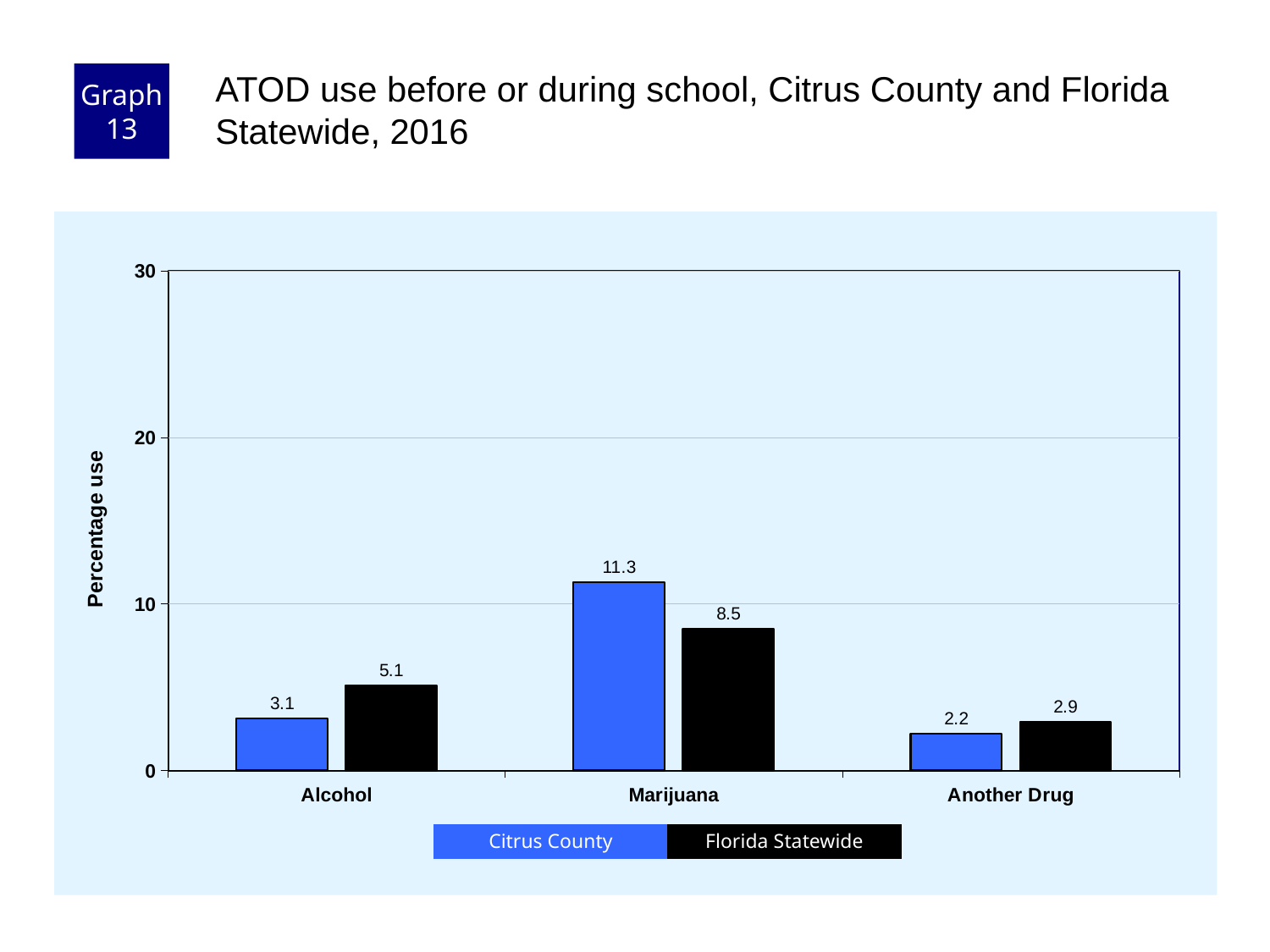
How many series does the legend list? 2 Which category has the highest Citrus County value? Marijuana How many categories are shown on the x axis? 3 What is the Citrus County value for Marijuana? 11.3 What is the Florida Statewide value for Alcohol? 5.1 What kind of chart is shown on the slide? bar chart Which category has the lowest Florida Statewide value? Another Drug What is the Citrus County value for Another Drug? 2.2 What is the difference between the Citrus County and Florida Statewide values for Marijuana? 2.8 Which is larger for Alcohol, the Citrus County value or the Florida Statewide value? Florida Statewide Is the Citrus County value for Marijuana greater or less than 10? greater What is the difference between the Florida Statewide and Citrus County values for Alcohol? 2.0